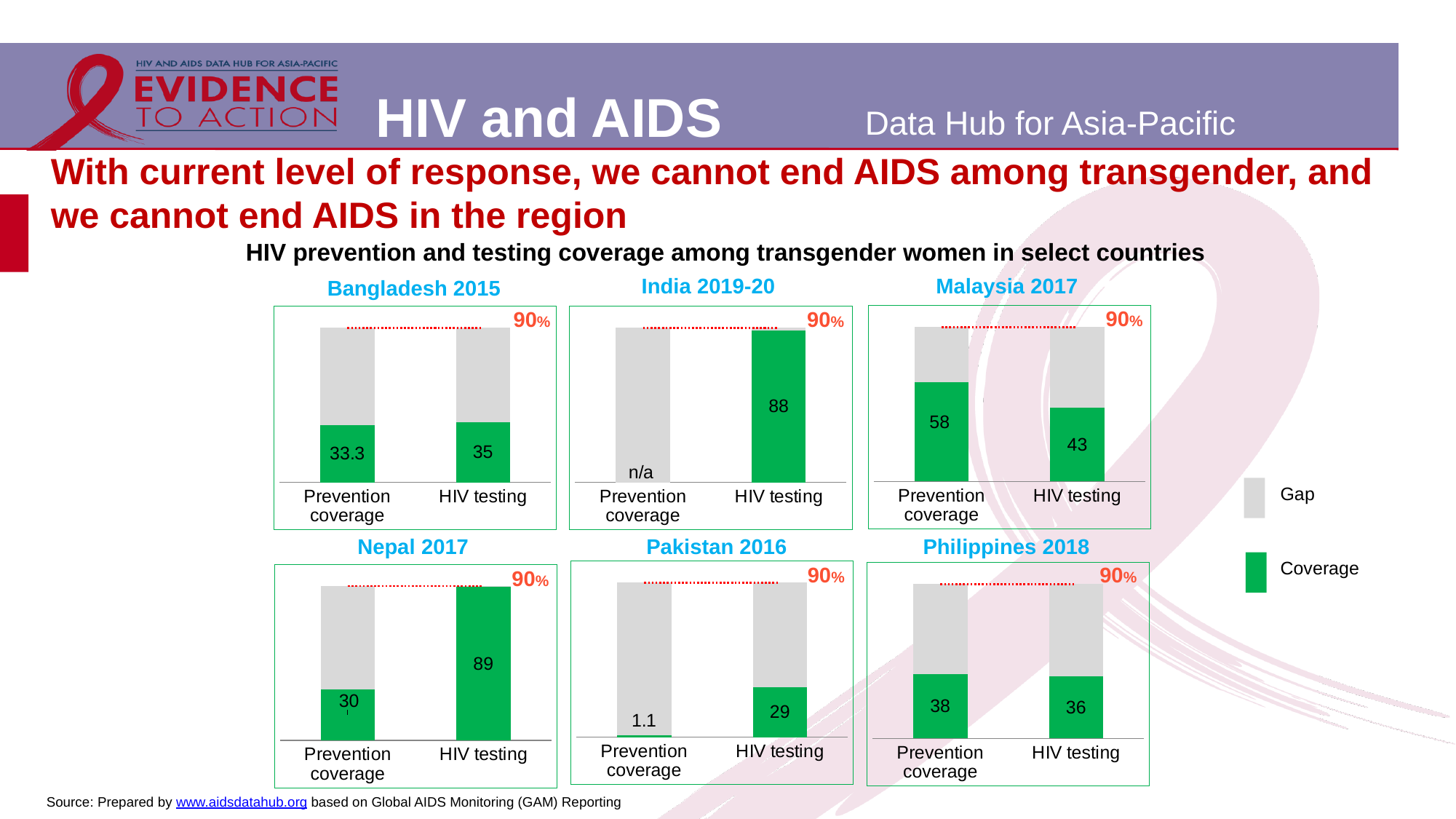
In the Malaysia 2017 chart, what is the difference between Prevention coverage and HIV testing? 15 In the Malaysia 2017 chart, what is the value for Prevention coverage? 58 What kind of chart is used for each country on this slide? Bar chart How many series does the legend on the slide list? 2 In the India 2019-20 chart, what is the value for HIV testing? 88 In the India 2019-20 chart, what is shown for Prevention coverage? n/a In the Pakistan 2016 chart, what is the value for Prevention coverage? 1.1 In the Bangladesh 2015 chart, what is the value for Prevention coverage? 33.3 In the Philippines 2018 chart, which is larger: Prevention coverage or HIV testing? Prevention coverage What target level is marked by the dotted red line on each chart? 90% In the Nepal 2017 chart, what is the value for HIV testing? 89 In the Nepal 2017 chart, what is the difference between HIV testing and Prevention coverage? 59